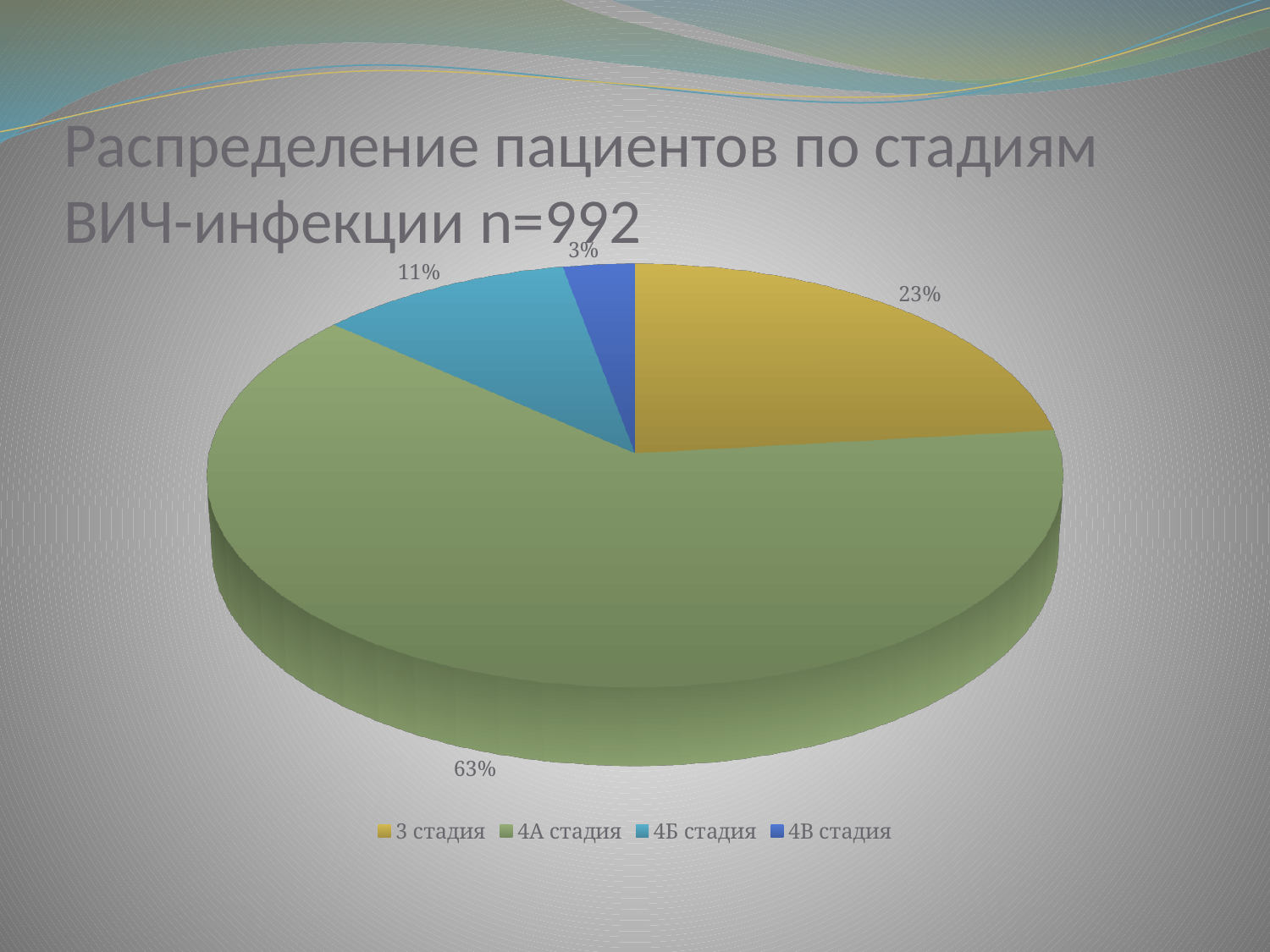
What share of the pie does the 3 стадия slice represent? 23% Which stage has the smallest share of patients? 4В стадия What is the difference in percentage points between the 4Б стадия and 4В стадия slices? 8 What kind of chart is shown on the slide? Pie chart Which stage has the largest share of patients? 4А стадия What is the title of the chart on the slide? Распределение пациентов по стадиям ВИЧ-инфекции n=992 Which slice is larger: 3 стадия or 4Б стадия? 3 стадия What share of the pie does the 4А стадия slice represent? 63% What share of the pie does the 4Б стадия slice represent? 11% What is the difference in percentage points between the 4А стадия and 3 стадия slices? 40 How many slices does the pie chart have? 4